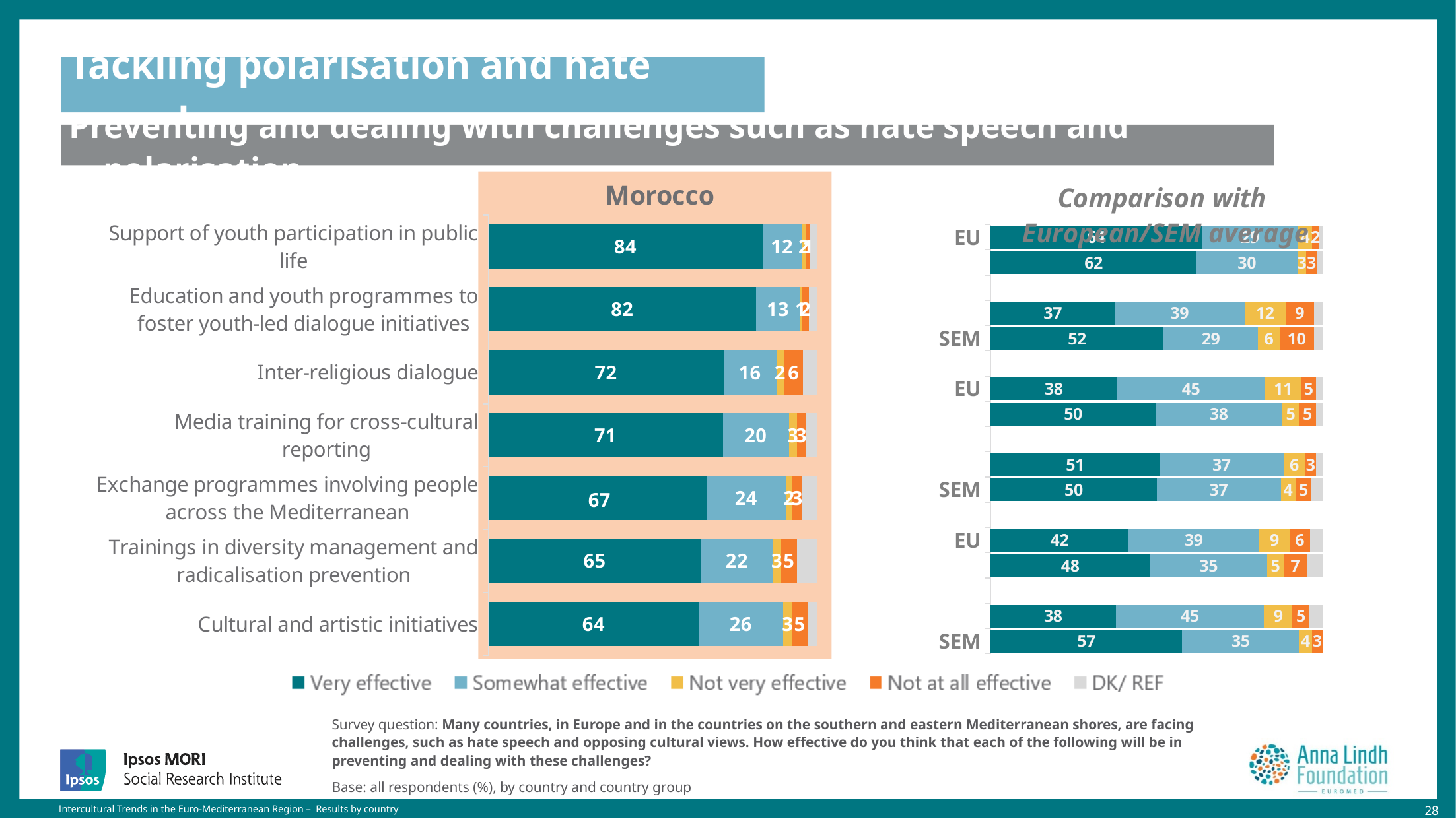
How many categories are shown in the Morocco chart? 7 In the Morocco chart, what percentage rated 'Support of youth participation in public life' as very effective? 84 What kind of chart is the Morocco chart? Stacked bar chart In the Morocco chart, which category has the lowest 'Very effective' value? Cultural and artistic initiatives In the Morocco chart, what is the 'Somewhat effective' value for 'Media training for cross-cultural reporting'? 20 In the Morocco chart, what is the 'Not at all effective' value for 'Inter-religious dialogue'? 6 In the Morocco chart, what is the 'Somewhat effective' value for 'Cultural and artistic initiatives'? 26 In the Morocco chart, which category has the highest 'Very effective' value? Support of youth participation in public life In the Morocco chart, which has a larger 'Very effective' value: 'Inter-religious dialogue' or 'Media training for cross-cultural reporting'? Inter-religious dialogue How many series does the legend list? 5 In the Morocco chart, do the 'Very effective' values rise or fall going down the list of categories from top to bottom? Fall In the Morocco chart, what is the difference between the 'Very effective' values for 'Support of youth participation in public life' and 'Cultural and artistic initiatives'? 20